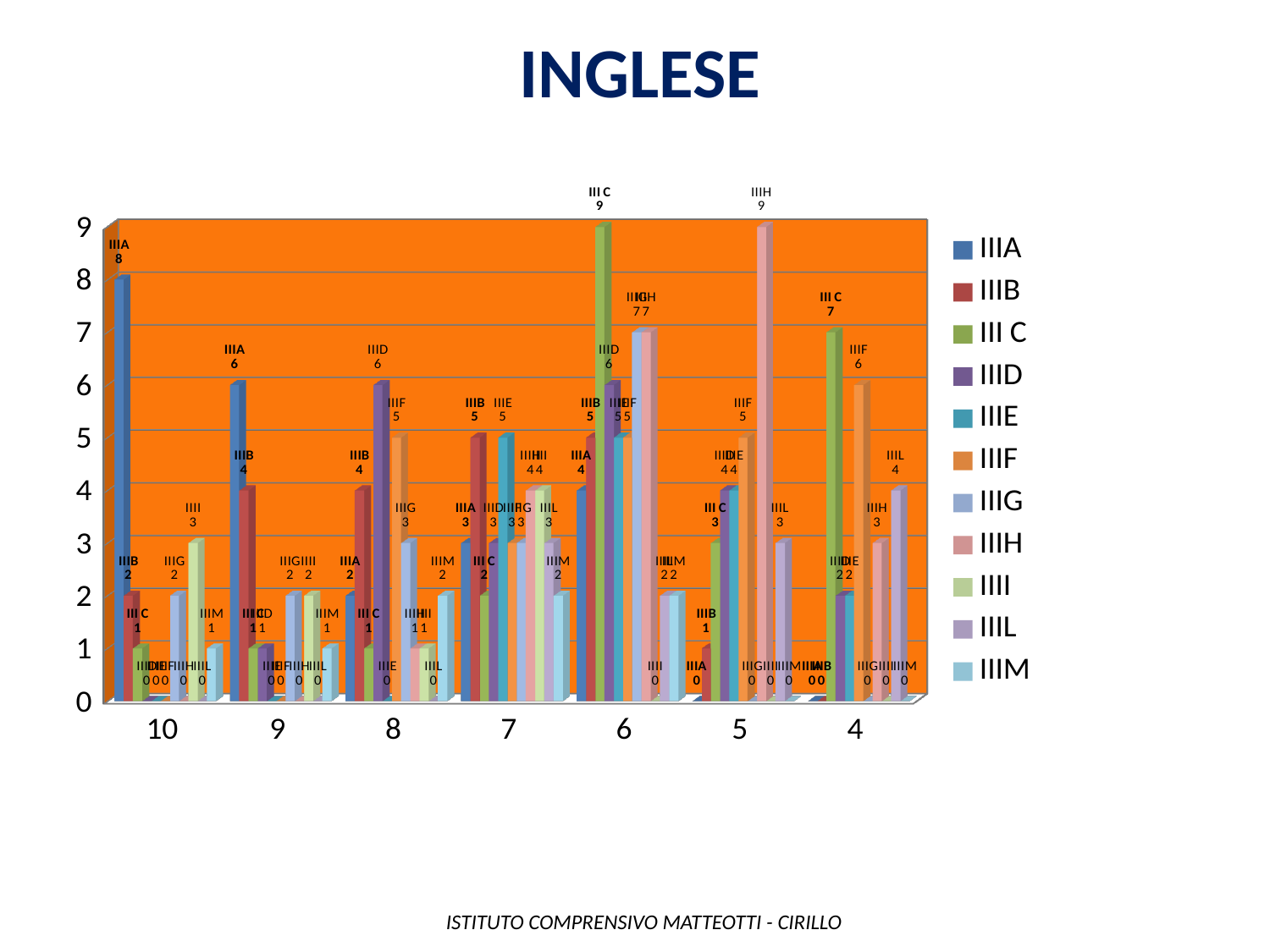
What is the value for IIIA at category 10? 8 How many categories are shown on the x axis? 7 Which is larger: III C at category 4 or IIIF at category 4? III C What is the value for III C at category 6? 9 What is the value for IIIH at category 5? 9 How many series does the legend list? 11 What is the value for IIID at category 8? 6 Which series has the highest value at category 10? IIIA What kind of chart is shown on the slide? bar chart What is the value for IIIF at category 4? 6 What is the title of the chart? INGLESE What is the difference between IIIA at category 10 and IIIA at category 9? 2